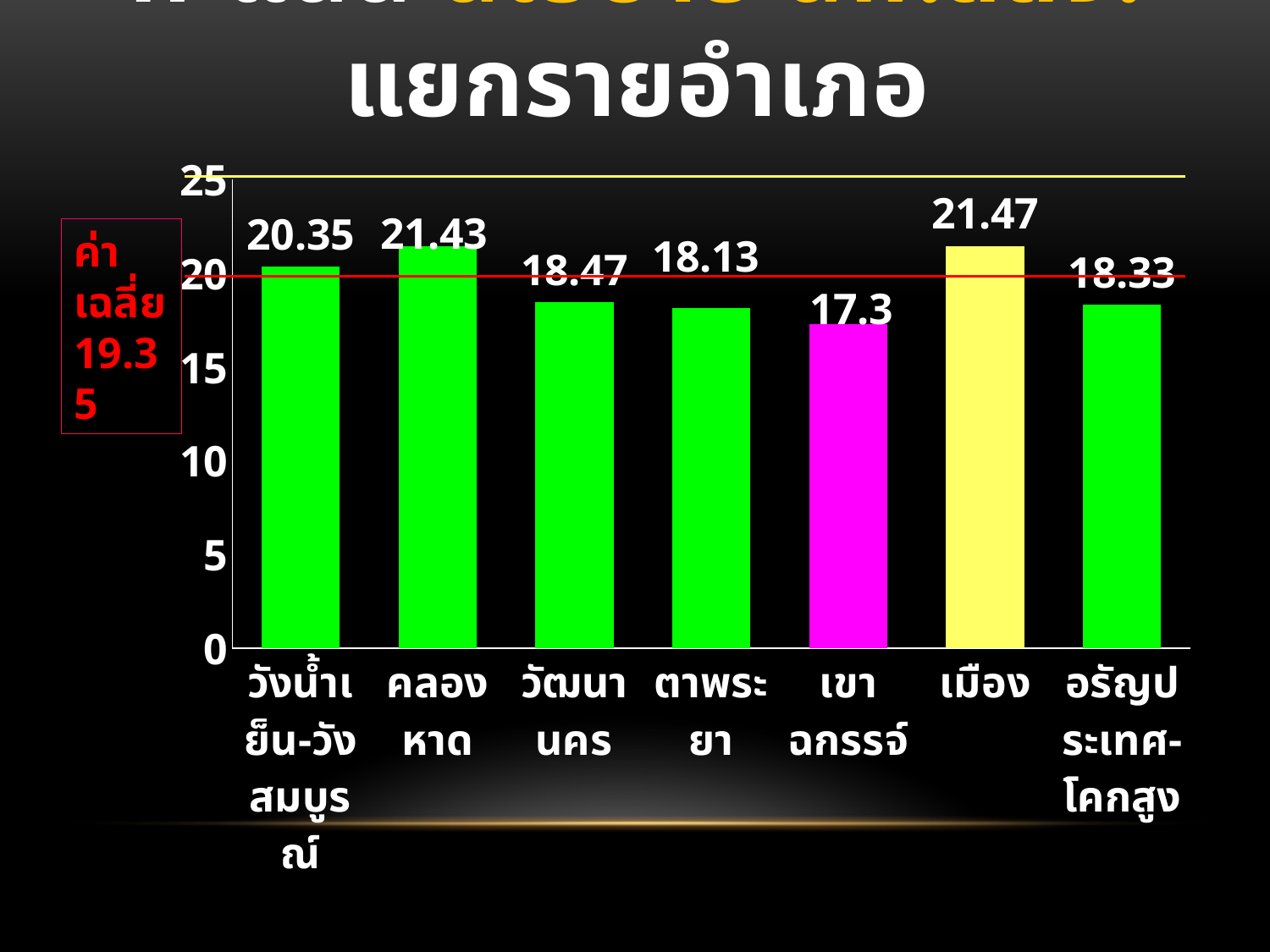
What is the value for อรัญประเทศ-โคกสูง? 18.33 What is the value for เขาฉกรรจ์? 17.3 Which district has the lowest value? เขาฉกรรจ์ What kind of chart is shown on the slide? bar chart What is the value for คลองหาด? 21.43 Which is larger, the value for วัฒนานคร or the value for เขาฉกรรจ์? วัฒนานคร Is the value for ตาพระยา greater or less than 20? less How many districts (bars) are shown in the chart? 7 What is the value for เมือง? 21.47 What average value (ค่าเฉลี่ย) is shown in the red box on the slide? 19.35 What is the difference between the values for วังน้ำเย็น-วังสมบูรณ์ and ตาพระยา? 2.22 Which district has the highest value? เมือง